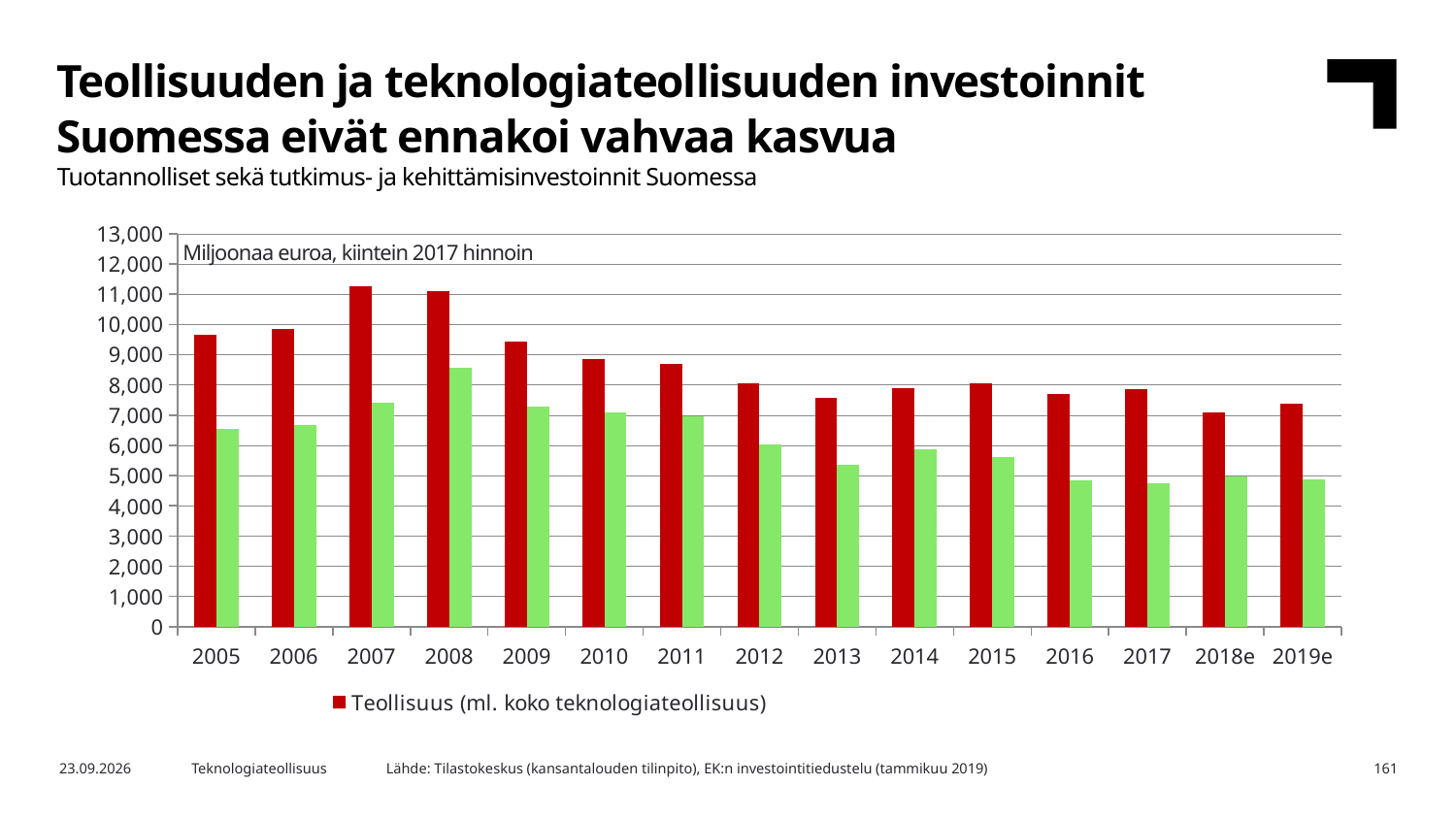
How many series does the chart's legend list? 1 How many years (categories) are shown on the x axis of the chart? 15 Is the value of the red bar (Teollisuus) for 2007 greater or less than 11,000? greater In which year is the red bar (Teollisuus) the lowest? 2018e Is the value of the green bar for 2008 greater or less than 8,000? greater Which is larger, the red bar (Teollisuus) for 2009 or the red bar for 2012? 2009 What kind of chart is shown on the slide? Bar chart In which year is the red bar (Teollisuus) the highest? 2007 In which year is the green bar the highest? 2008 Is the value of the green bar for 2013 greater or less than 5,000? greater Do the red bars (Teollisuus) generally rise or fall from 2007 to 2018e? Fall